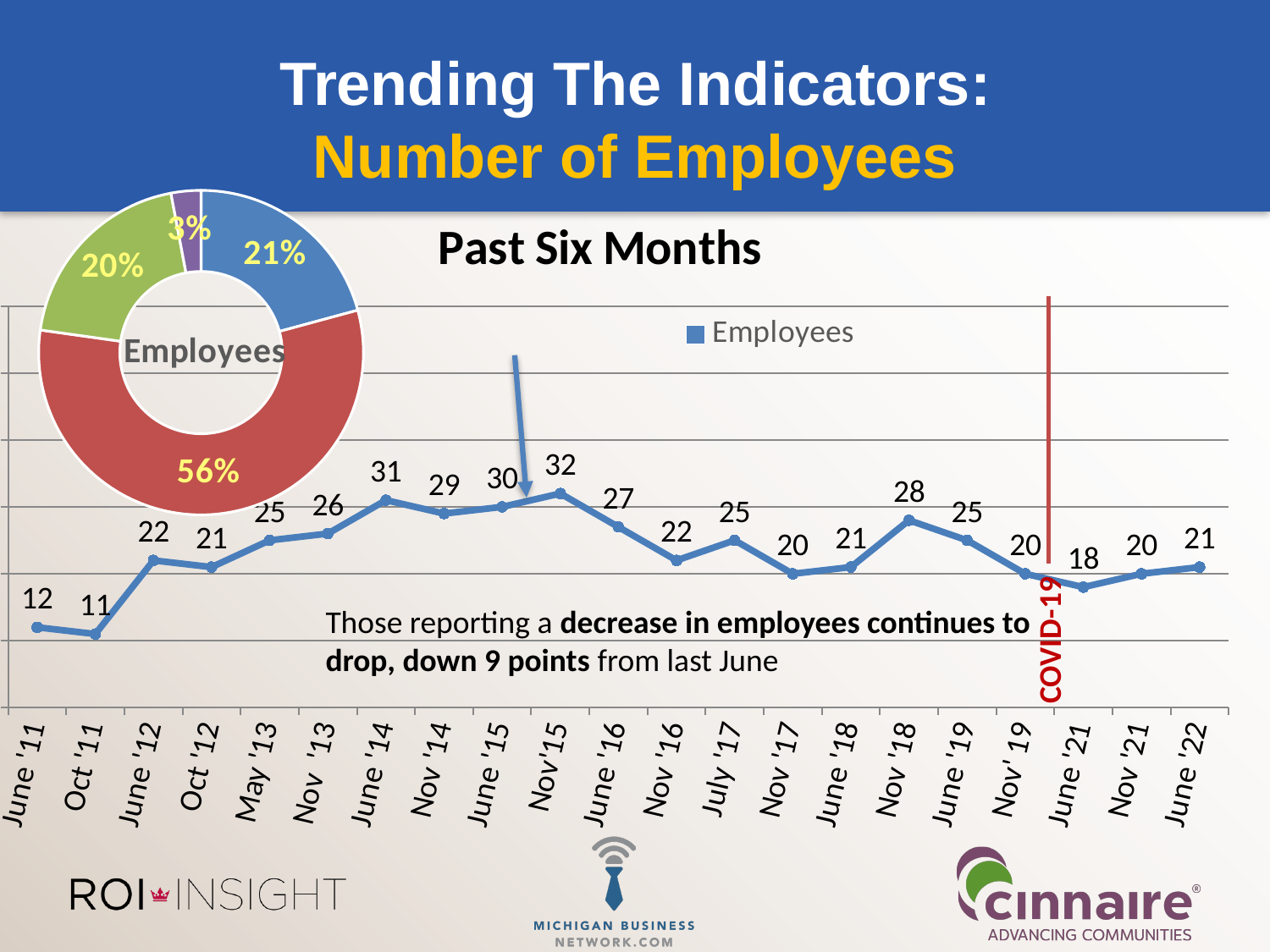
How many slices does the donut chart titled "Employees" have? 4 How many data points are plotted in the line chart titled "Past Six Months"? 21 In the line chart titled "Past Six Months", what is the value for Nov'15? 32 How many series does the legend of the line chart titled "Past Six Months" list? 1 In the donut chart titled "Employees", what is the share of the largest slice? 56% In the line chart titled "Past Six Months", what is the value for June '21? 18 In the line chart titled "Past Six Months", which period has the lowest value? Oct '11 What kind of chart is the "Employees" chart in the top-left of the slide? Donut chart In the line chart titled "Past Six Months", which is larger, the value for Nov '18 or the value for June '19? Nov '18 In the line chart titled "Past Six Months", what is the difference between the values for June '14 and June '21? 13 In the line chart titled "Past Six Months", which period has the highest value? Nov'15 In the line chart titled "Past Six Months", what is the value for June '22? 21